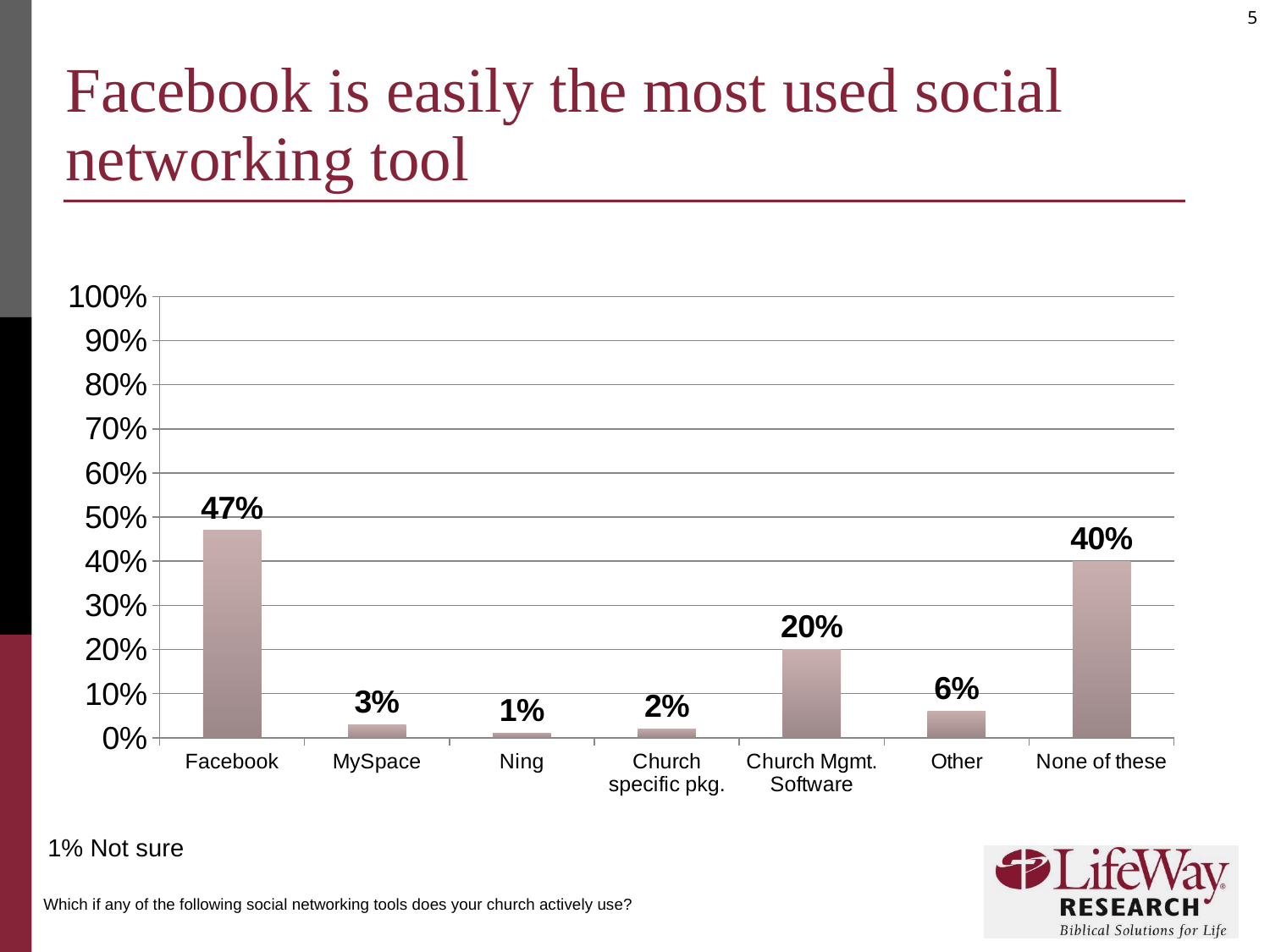
What kind of chart is shown on the slide? Bar chart Which is larger, the value for Church Mgmt. Software or the value for Other? Church Mgmt. Software Which category has the lowest value? Ning What is the value shown for MySpace? 3% What is the value shown for None of these? 40% What is the difference between the values for Facebook and None of these? 7% What is the value shown for Church Mgmt. Software? 20% What percentage of churches actively use Facebook? 47% How many categories are shown on the x axis? 7 What is the difference between the values for Other and Church specific pkg.? 4% What is the title of the slide containing the chart? Facebook is easily the most used social networking tool Which category has the highest value? Facebook